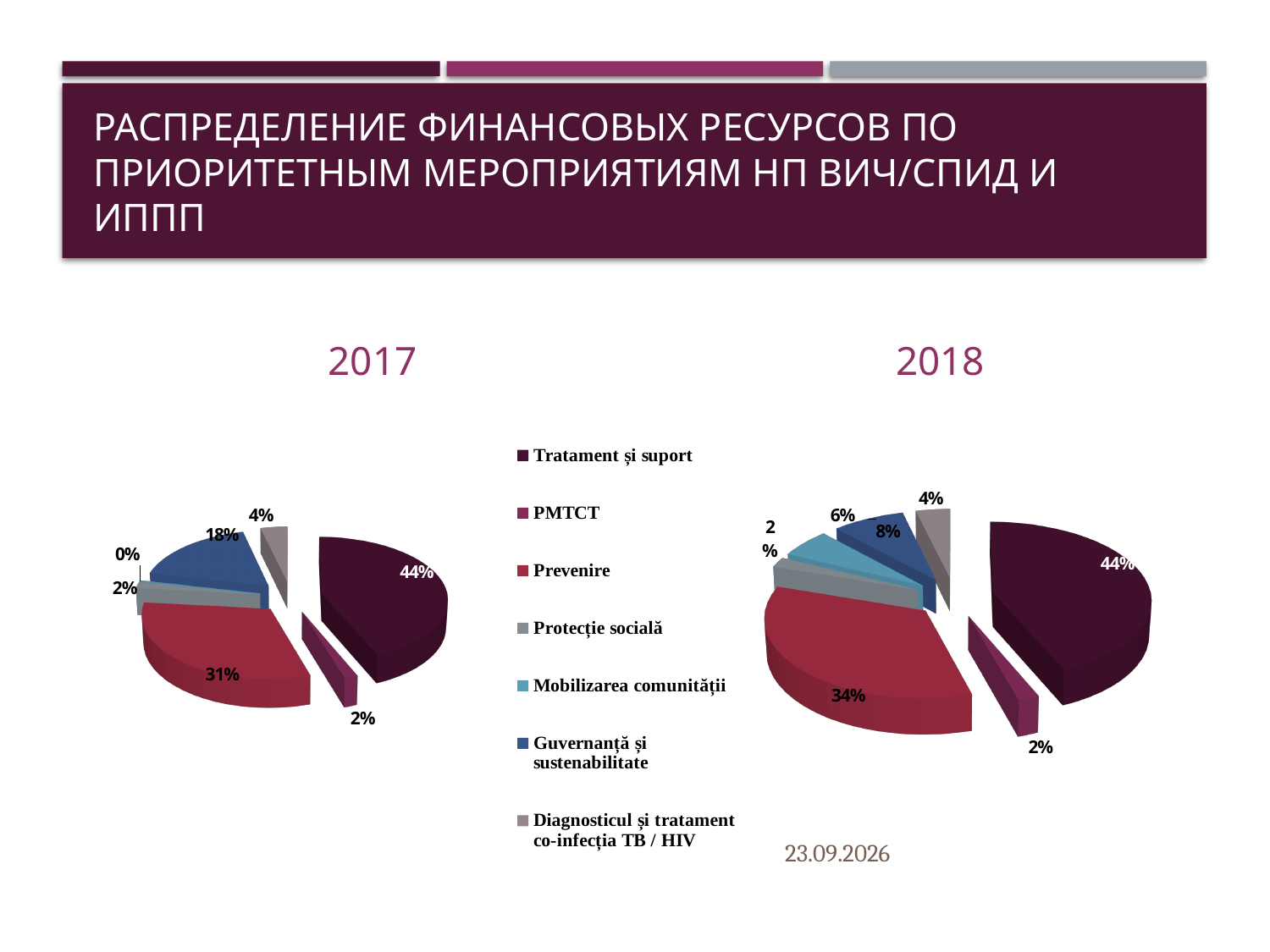
What is the difference between the Prevenire share in the 2018 pie chart and the Prevenire share in the 2017 pie chart? 3% In the 2018 pie chart, what share is labelled for Mobilizarea comunității? 6% In the 2017 pie chart, what share is labelled for Tratament și suport? 44% How many entries does the legend shared by the two pie charts list? 7 In the 2018 pie chart, what share is labelled for Guvernanță și sustenabilitate? 8% In the 2018 pie chart, which is larger: the share for Guvernanță și sustenabilitate or the share for Diagnosticul și tratament co-infecția TB / HIV? Guvernanță și sustenabilitate In the 2017 pie chart, which category has the smallest share? Mobilizarea comunității In the 2017 pie chart, what share is labelled for Guvernanță și sustenabilitate? 18% In the 2017 pie chart, what share is labelled for Prevenire? 31% In the 2018 pie chart, what share is labelled for Prevenire? 34% What type of chart is used for the 2017 and 2018 data on the slide? Pie chart In the 2017 pie chart, which category has the largest share? Tratament și suport